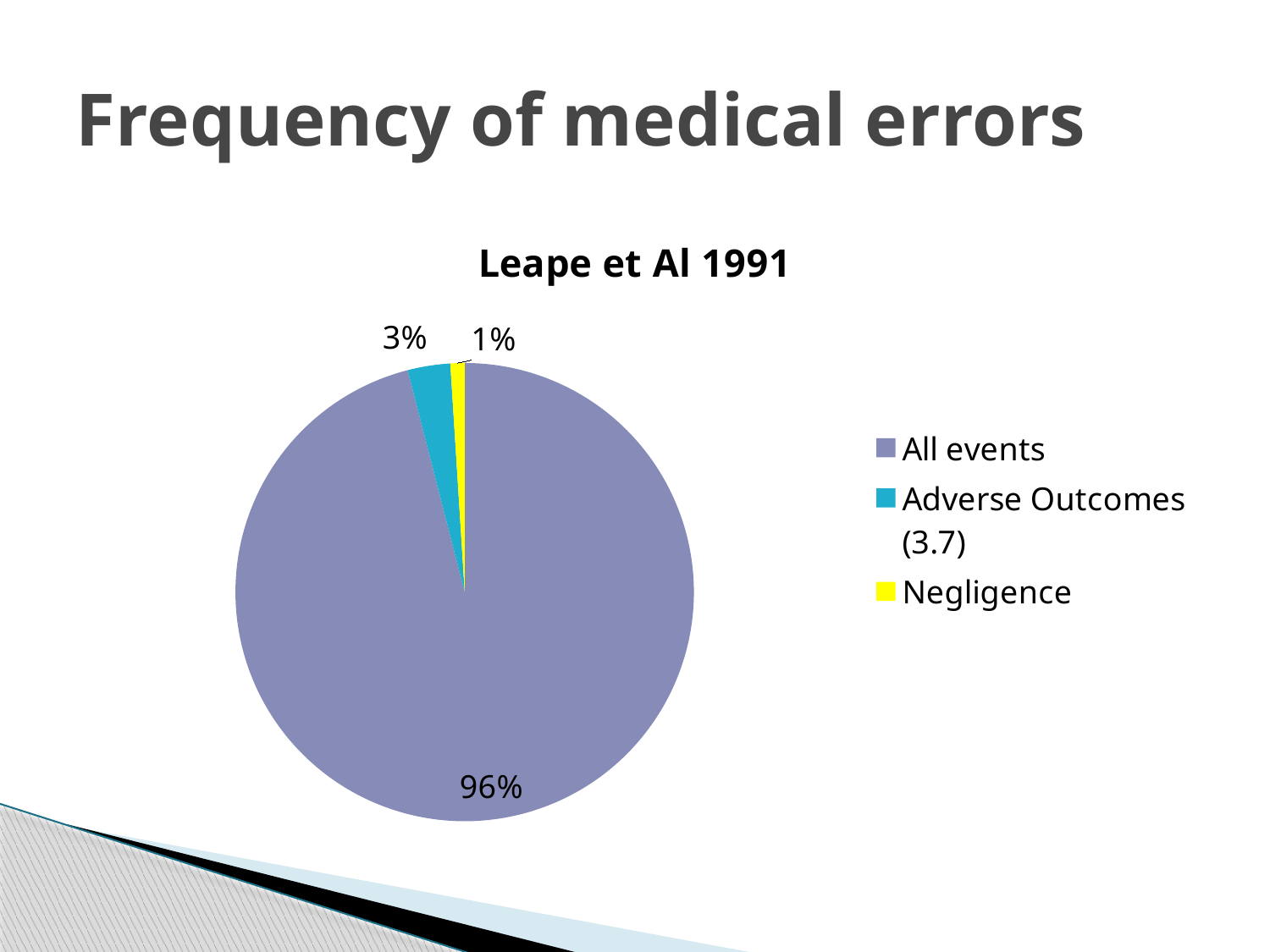
Which category has the smallest slice of the pie? Negligence How many categories does the legend list? 3 What type of chart is shown on the slide? pie chart What is the difference in percentage points between the All events slice and the Adverse Outcomes (3.7) slice? 93 What percentage of the pie is labelled for Adverse Outcomes (3.7)? 3% What is the difference in percentage points between the Adverse Outcomes (3.7) slice and the Negligence slice? 2 What percentage of the pie is labelled for All events? 96% What percentage of the pie is labelled for Negligence? 1% Which category has the largest slice of the pie? All events Which is larger, the slice for Adverse Outcomes (3.7) or the slice for Negligence? Adverse Outcomes (3.7) What colour is the slice for Negligence? yellow What is the title of the chart? Leape et Al 1991